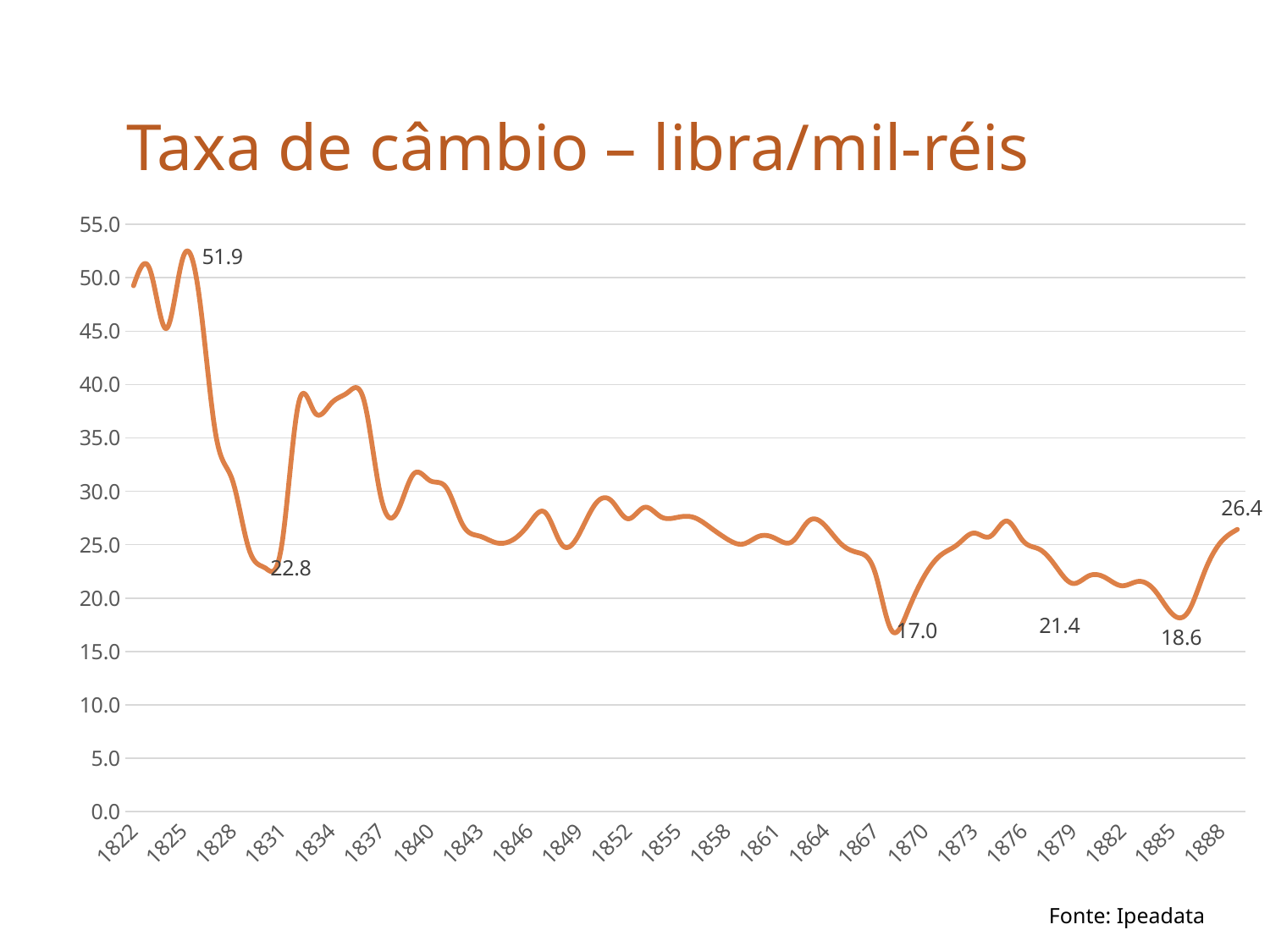
What is the difference between the highest labelled value (51.9) and the lowest labelled value (17.0)? 34.9 Is the value for 1858 greater or less than 30.0? less What is the difference between the final labelled value 26.4 and the labelled low of 18.6 just before it? 7.8 Which labelled value is larger, 21.4 or 18.6? 21.4 What kind of chart is shown on the slide? line chart What is the title of the chart? Taxa de câmbio – libra/mil-réis What is the value labelled at the final point of the line, at the right end of the chart? 26.4 Is the value for 1822 greater or less than 45.0? greater What is the highest value labelled on the line? 51.9 What is the lowest value labelled on the line? 17.0 What source is cited at the bottom of the slide? Fonte: Ipeadata Overall, does the exchange rate rise or fall from 1822 to 1888? fall